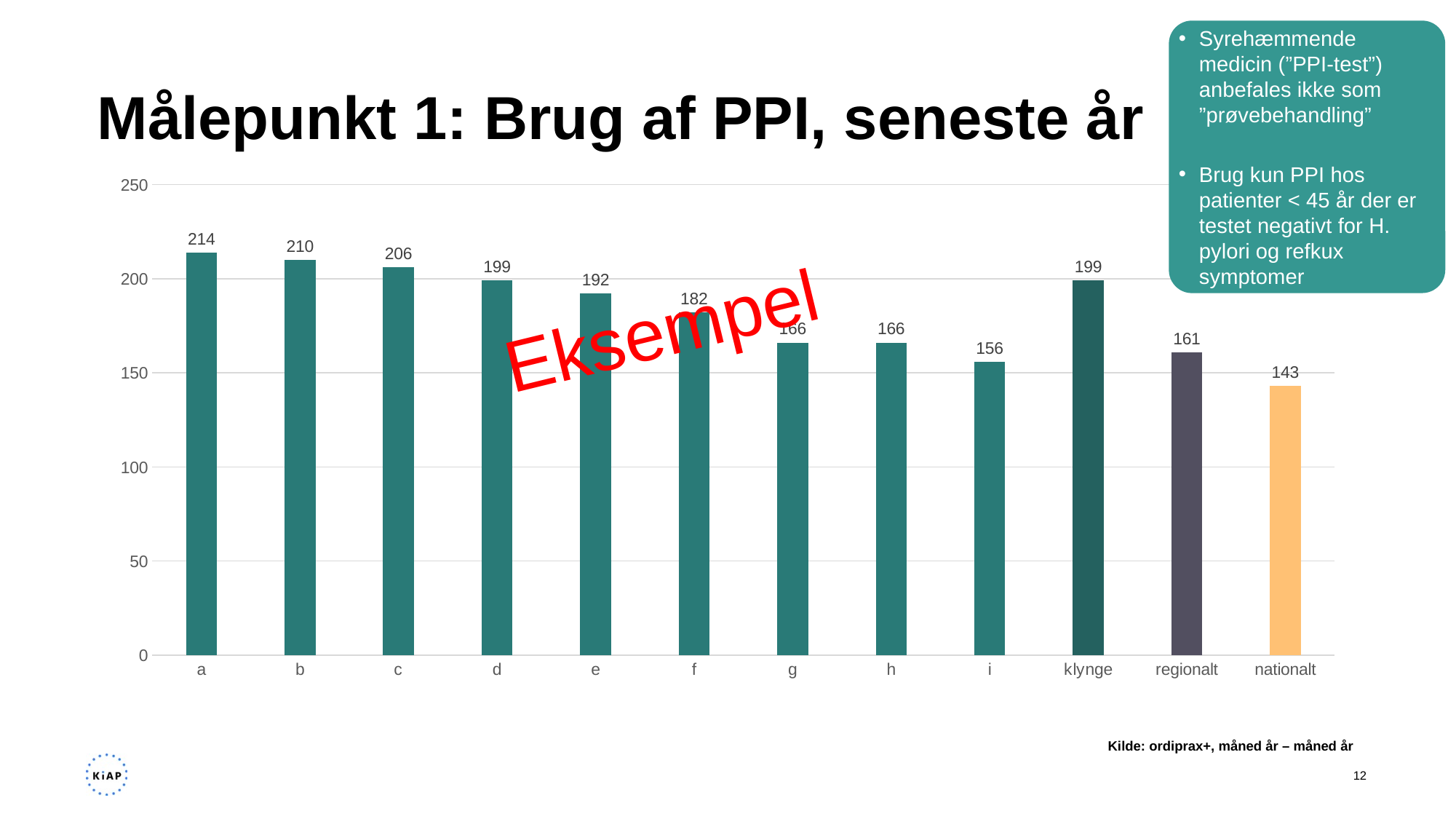
What kind of chart is shown on the slide? bar chart What is the value for nationalt? 143 Which category has the lowest value? nationalt How many categories are shown on the x axis? 12 What is the difference between the values for klynge and regionalt? 38 What is the value for category a? 214 Do the values rise or fall from category a to category i? fall Which category has the highest value? a What is the difference between the values for a and nationalt? 71 Which is larger, the value for c or the value for e? c What is the value for klynge? 199 What is the value for regionalt? 161